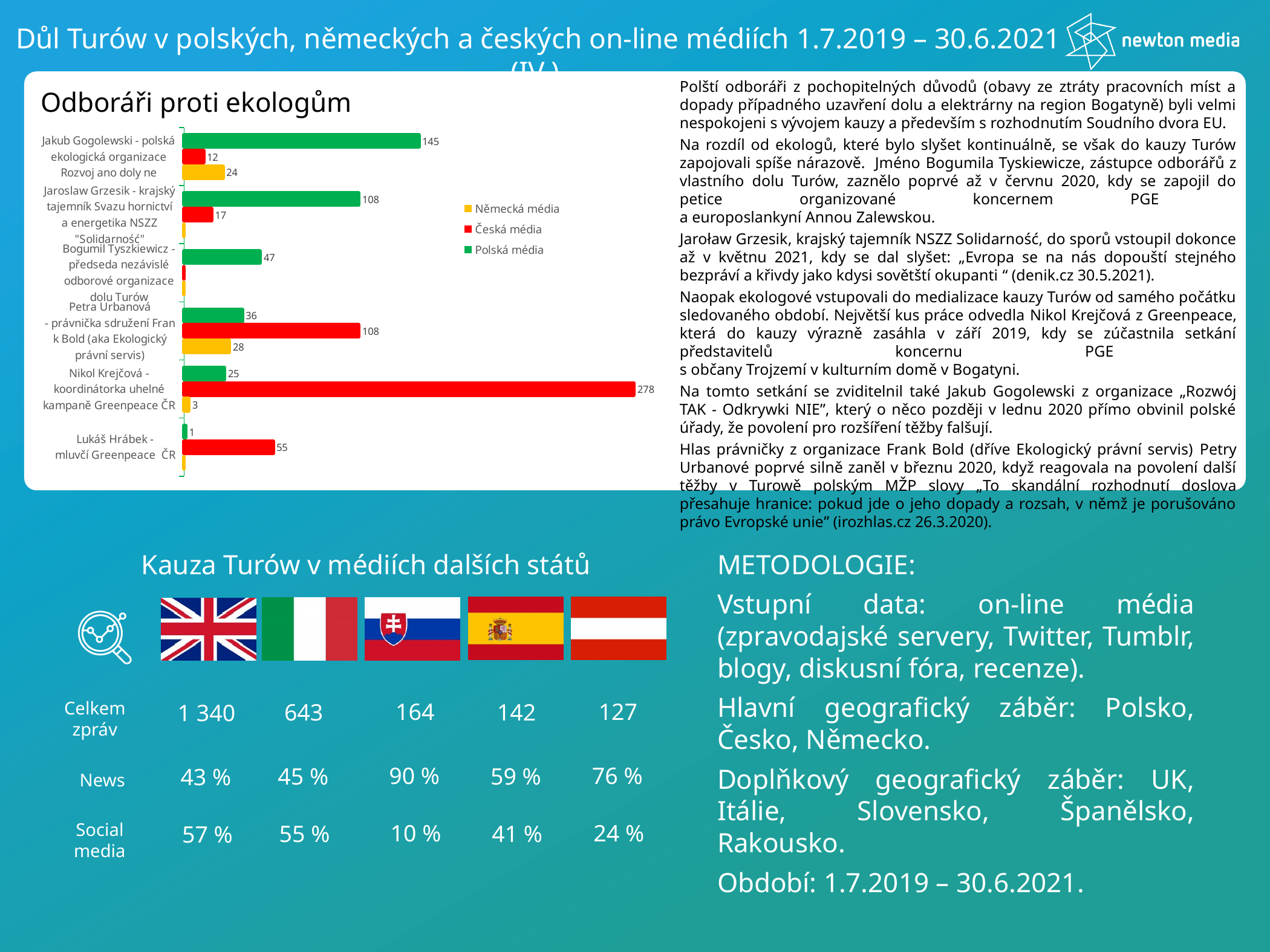
What type of chart is 'Odboráři proti ekologům'? Bar chart In the chart 'Odboráři proti ekologům', which person has the highest value for Česká média? Nikol Krejčová How many series does the legend of the chart 'Odboráři proti ekologům' list? 3 In the chart 'Odboráři proti ekologům', what is the value for Polská média for Jakub Gogolewski? 145 In the chart 'Odboráři proti ekologům', which person has the lowest value for Polská média? Lukáš Hrábek In the chart 'Odboráři proti ekologům', what is the value for Polská média for Bogumil Tyszkiewicz? 47 In the chart 'Odboráři proti ekologům', what is the value for Německá média for Petra Urbanová? 28 In the chart 'Odboráři proti ekologům', what is the value for Česká média for Nikol Krejčová? 278 In the chart 'Odboráři proti ekologům', what is the difference between the Česká média and Polská média values for Petra Urbanová? 72 How many people (categories) are shown in the chart 'Odboráři proti ekologům'? 6 In the chart 'Odboráři proti ekologům', what is the total of the three values shown for Jakub Gogolewski? 181 In the chart 'Odboráři proti ekologům', who has the larger Polská média value, Jakub Gogolewski or Jaroslaw Grzesik? Jakub Gogolewski